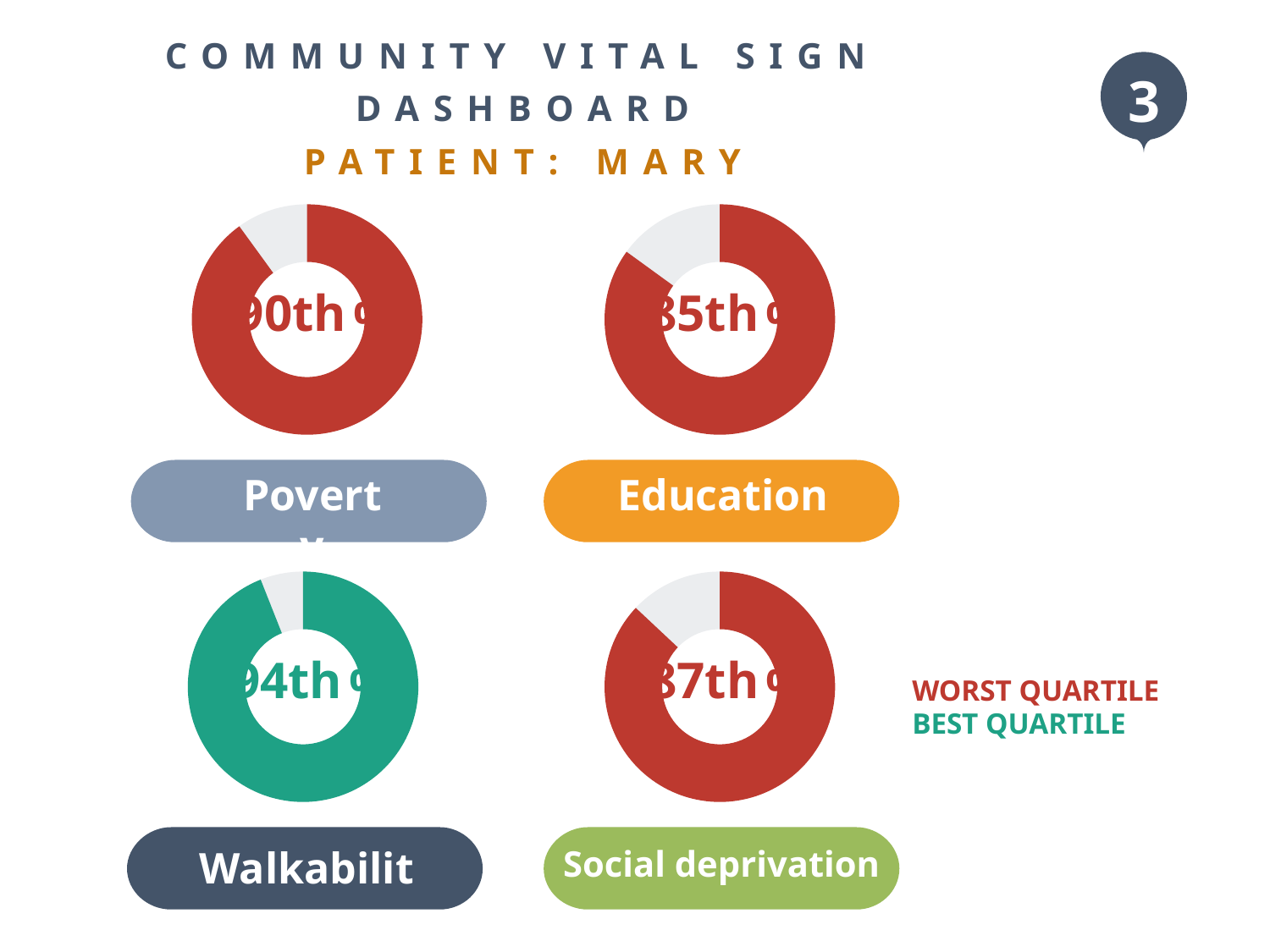
In the Walkability chart, what percentile value is printed in the centre? 94th In the Poverty chart, what percentile value is printed in the centre? 90th Across the four donut charts, which measure shows the lowest percentile? Education In the Social deprivation chart, what percentile value is printed in the centre? 87th What kind of charts are shown on the slide? Donut charts According to the key on the slide, what does the red colour of the donut rings indicate? Worst quartile Across the four donut charts, which measure shows the highest percentile? Walkability In the Education chart, what percentile value is printed in the centre? 85th Which has the larger percentile value, the Poverty chart or the Social deprivation chart? Poverty Which has the larger percentile value, the Walkability chart or the Education chart? Walkability How many donut charts are on the slide? 4 Which of the four donut charts is coloured green (best quartile)? Walkability